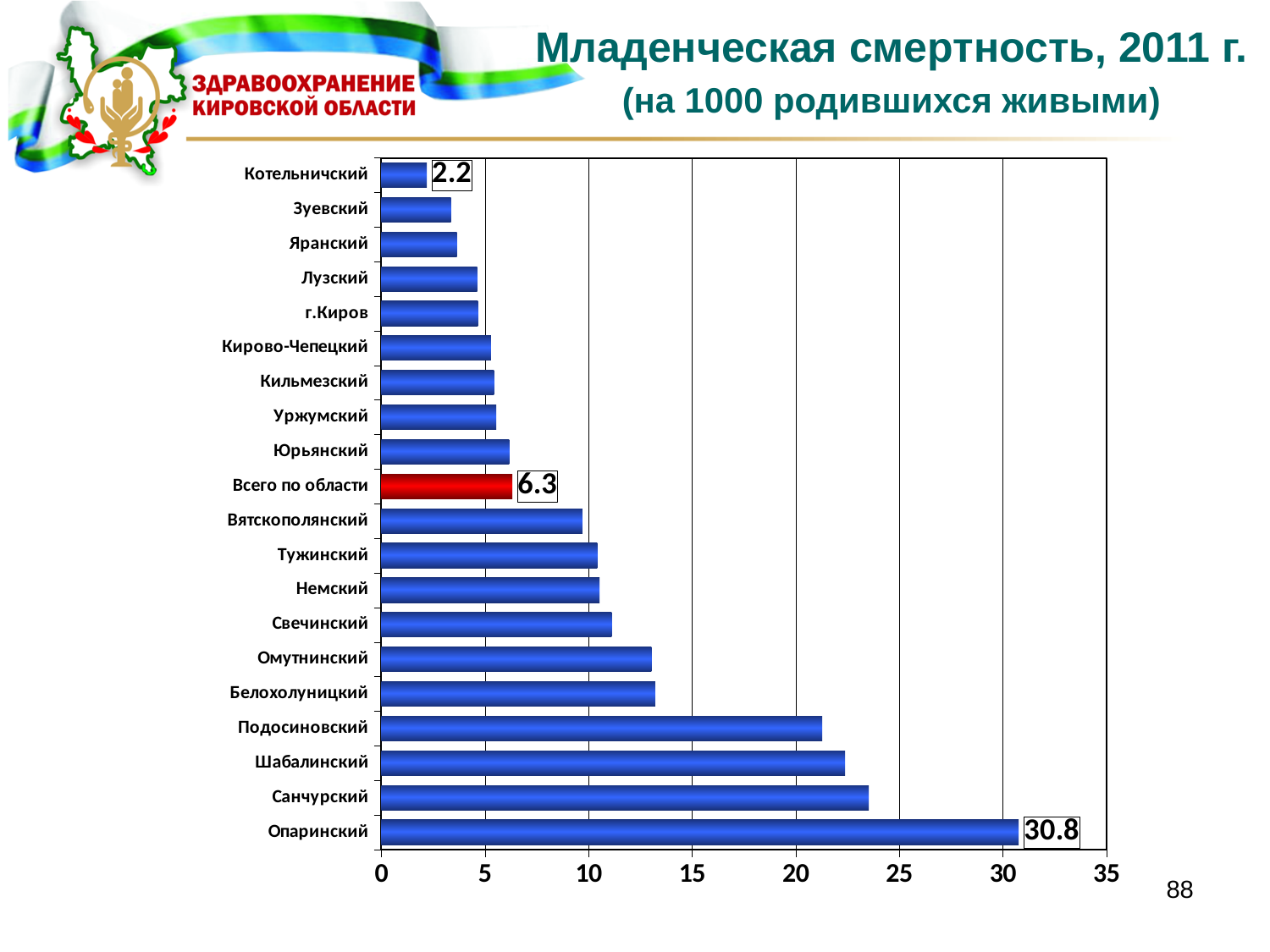
Which category has the highest value? Опаринский Is the value for Подосиновский greater or less than 20? greater Which category has the lowest value? Котельничский Is the value for Зуевский greater or less than 5? less What is the difference between the values for Опаринский and Котельничский? 28.6 What is the value for Всего по области? 6.3 Which is larger, the value for Подосиновский or the value for Белохолуницкий? Подосиновский How many categories are shown in the chart? 20 What is the value for Опаринский? 30.8 What is the value for Котельничский? 2.2 Which category is shown with a red bar? Всего по области What is the difference between the values for Всего по области and Котельничский? 4.1